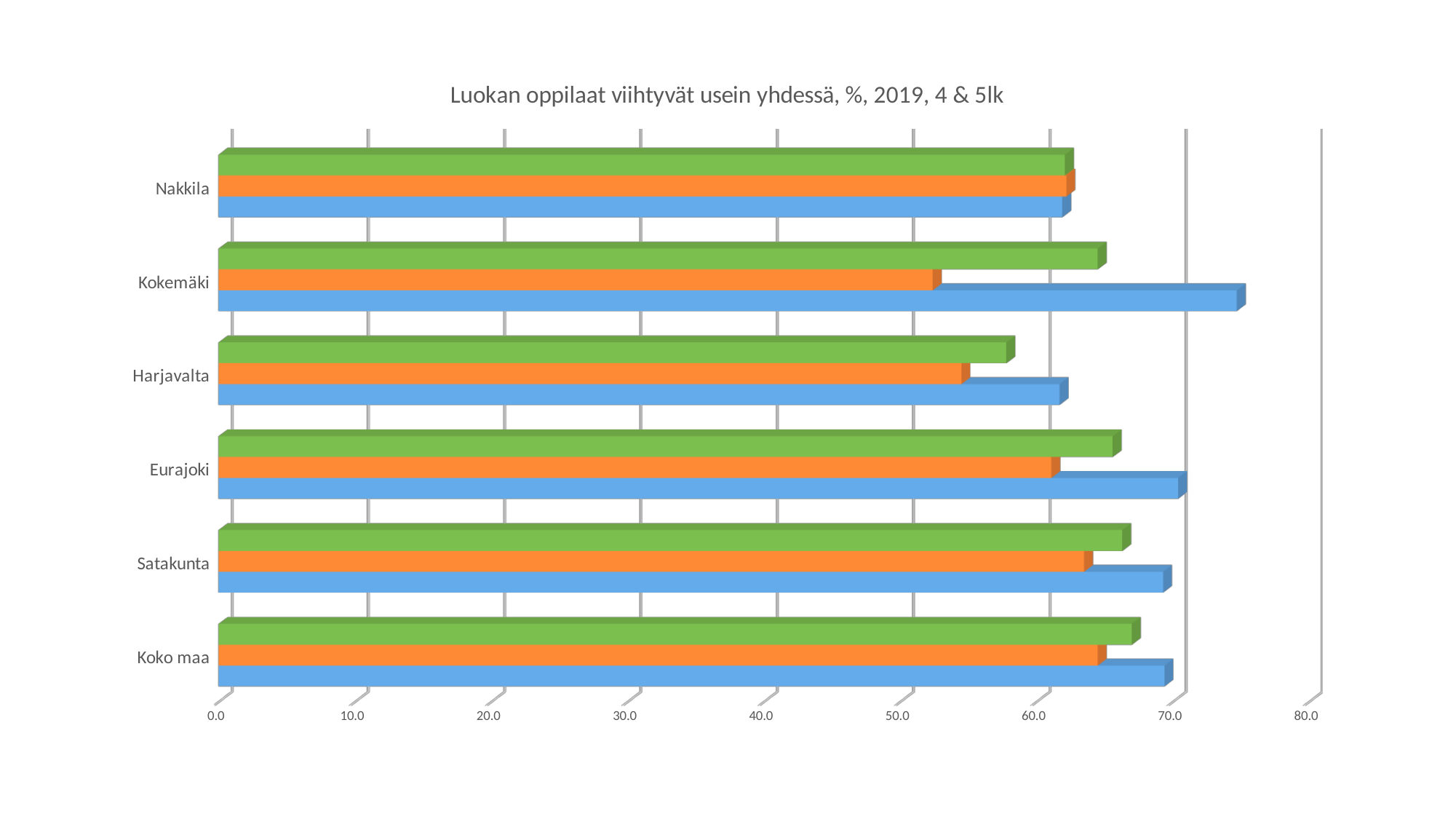
How many categories are shown on the vertical axis of the chart? 6 Is the value of the blue bar for Kokemäki greater or less than 70? greater For Kokemäki, which is larger: the blue bar or the orange bar? the blue bar Which category has the shortest orange bar? Kokemäki Which category has the longest blue bar? Kokemäki Is the value of the green bar for Nakkila greater or less than 60? greater Is the value of the green bar for Harjavalta greater or less than 60? less What kind of chart is shown on the slide? bar chart For Harjavalta, which is larger: the blue bar or the green bar? the blue bar How many bars are plotted for each category in the chart? 3 What is the title of the chart? Luokan oppilaat viihtyvät usein yhdessä, %, 2019, 4 & 5lk